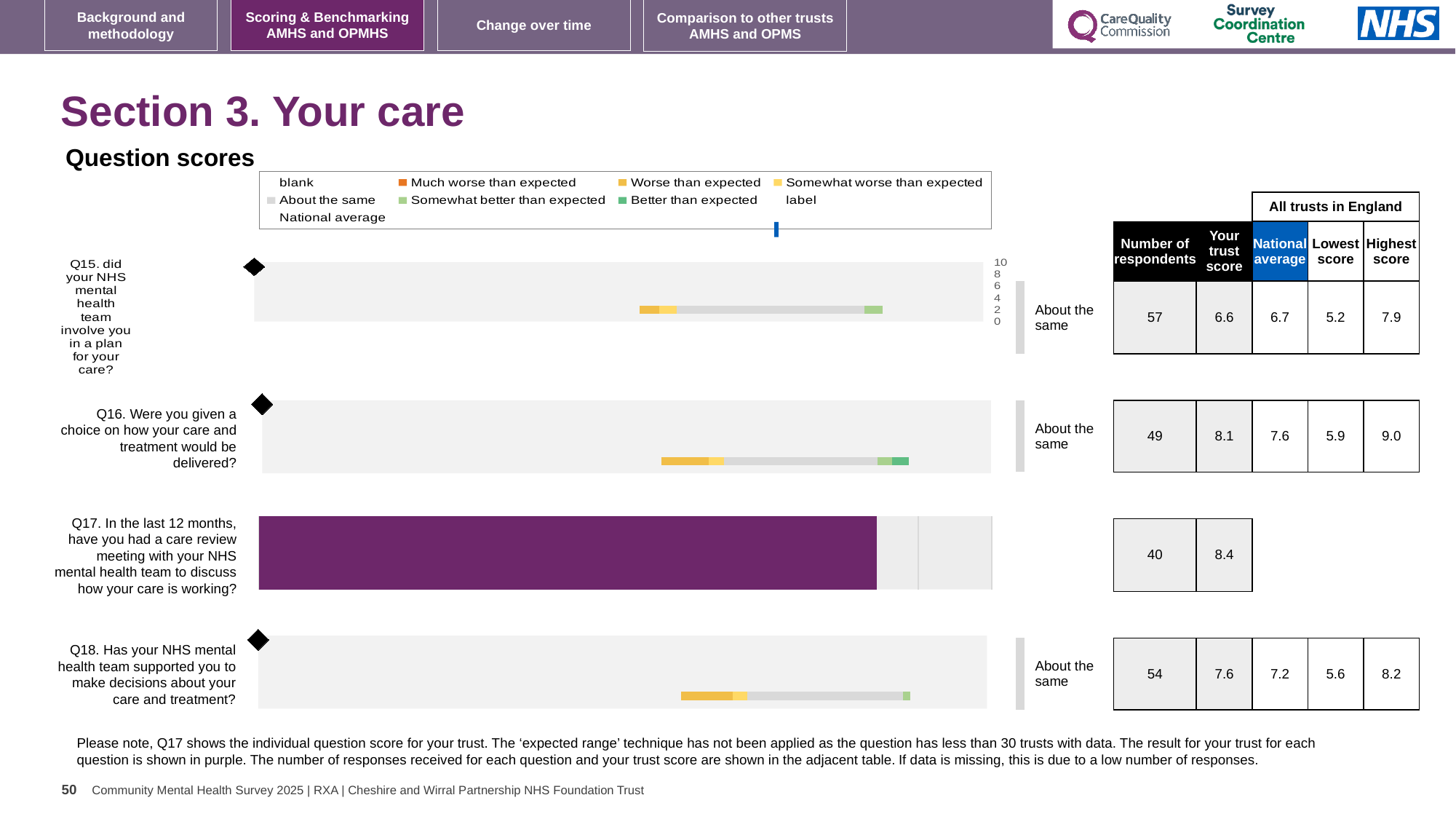
For Q18, which is larger: the trust score or the national average? the trust score How many respondents answered Q18 (Has your NHS mental health team supported you to make decisions about your care and treatment?)? 54 What is the trust score for Q16 (Were you given a choice on how your care and treatment would be delivered?)? 8.1 How many respondents answered Q17 (care review meeting in the last 12 months)? 40 How many questions (Q15 to Q18) are plotted in the question scores chart? 4 What kind of chart is used to show the question scores on this slide? bar chart What is the difference between the highest score and the lowest score for Q16? 3.1 Which question has the lowest trust score? Q15 What is the national average for Q15 (did your NHS mental health team involve you in a plan for your care?)? 6.7 Which question has the highest trust score? Q17 By how much does the trust score for Q16 exceed the national average? 0.5 Which question's bar is shown in purple rather than with the expected range colours? Q17